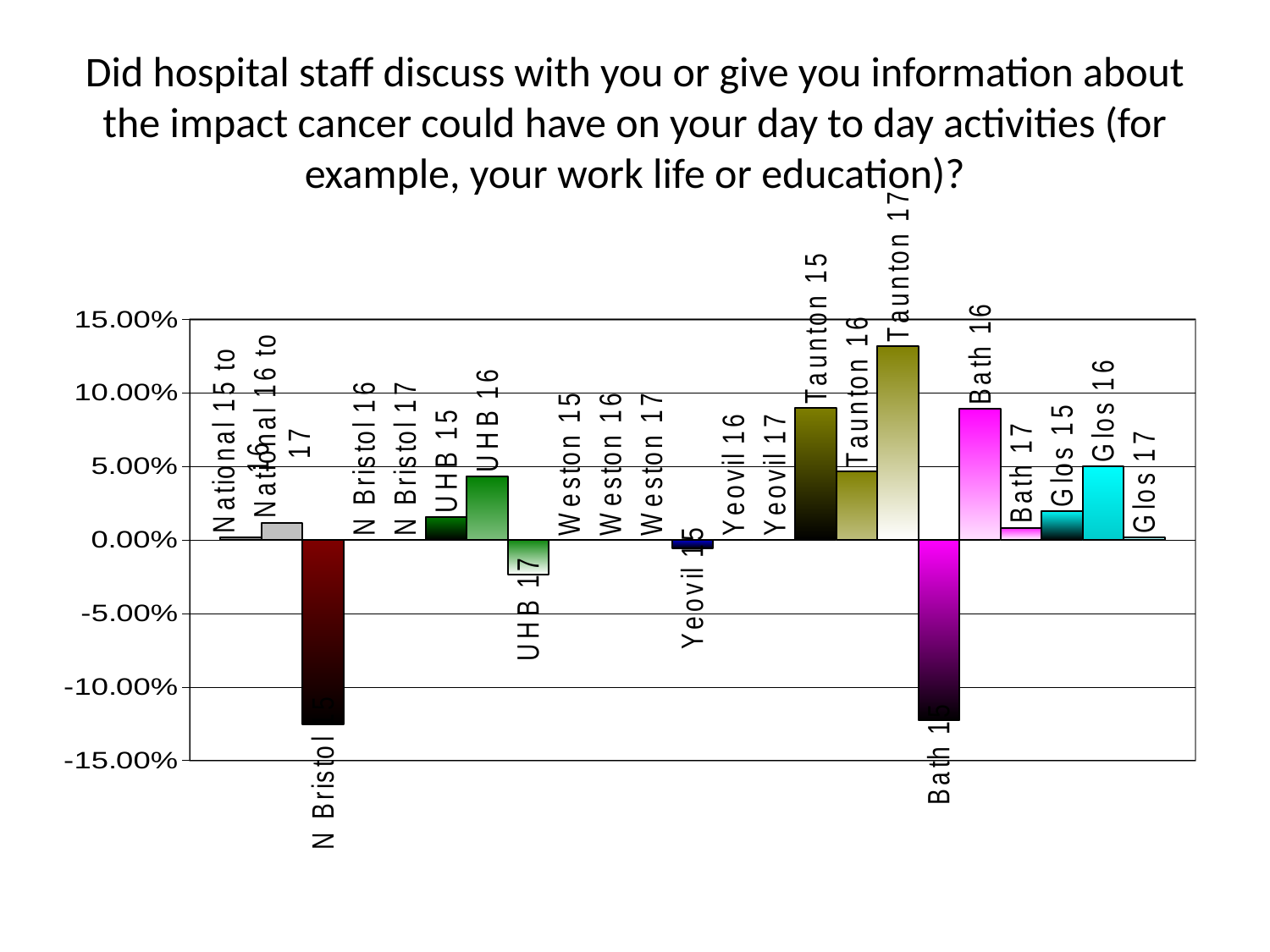
Is the value for Taunton 15 greater or less than 5.00%? greater Which is larger, the value for Bath 16 or Bath 17? Bath 16 Which category has the highest value in the chart? Taunton 17 Is the value for Bath 16 greater or less than 5.00%? greater Is the value for UHB 16 greater or less than 5.00%? less Which is larger, the value for Taunton 16 or Taunton 17? Taunton 17 Which is larger, the value for UHB 16 or UHB 17? UHB 16 How many categories are shown on the x axis of the chart? 23 What kind of chart is shown on the slide? bar chart